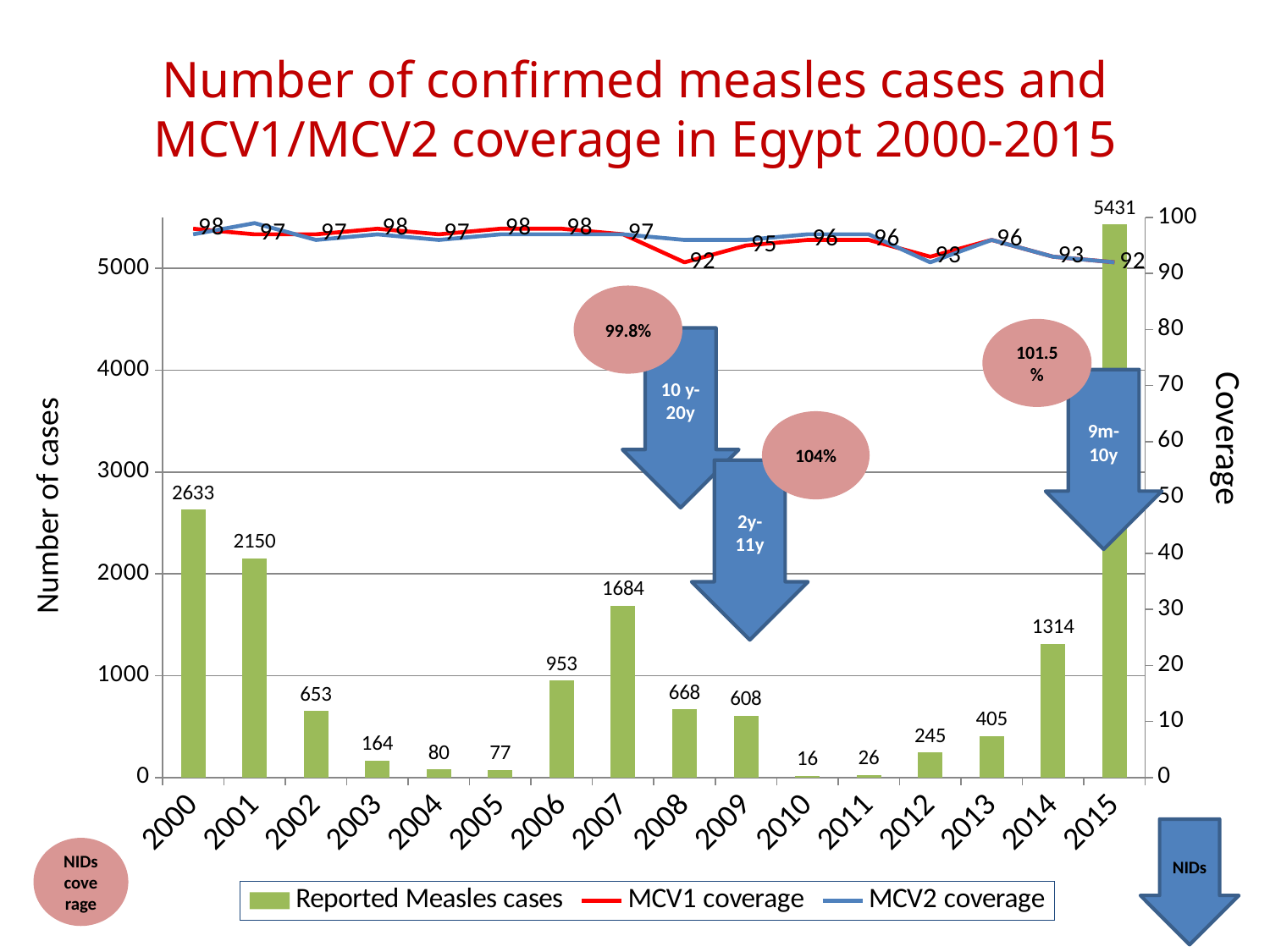
Did the number of reported measles cases rise or fall from 2012 to 2015? rise How many reported measles cases were there in 2015? 5431 How many series does the legend list? 3 What is the difference in reported measles cases between 2000 and 2001? 483 Which year had more reported measles cases, 2006 or 2014? 2014 How many reported measles cases were there in 2007? 1684 What colour is the MCV1 coverage line? Red Which year had the highest number of reported measles cases? 2015 How many years are shown on the x axis? 16 Is the number of reported measles cases in 2002 greater or less than 1000? less Which year had the lowest number of reported measles cases? 2010 How many reported measles cases were there in 2010? 16